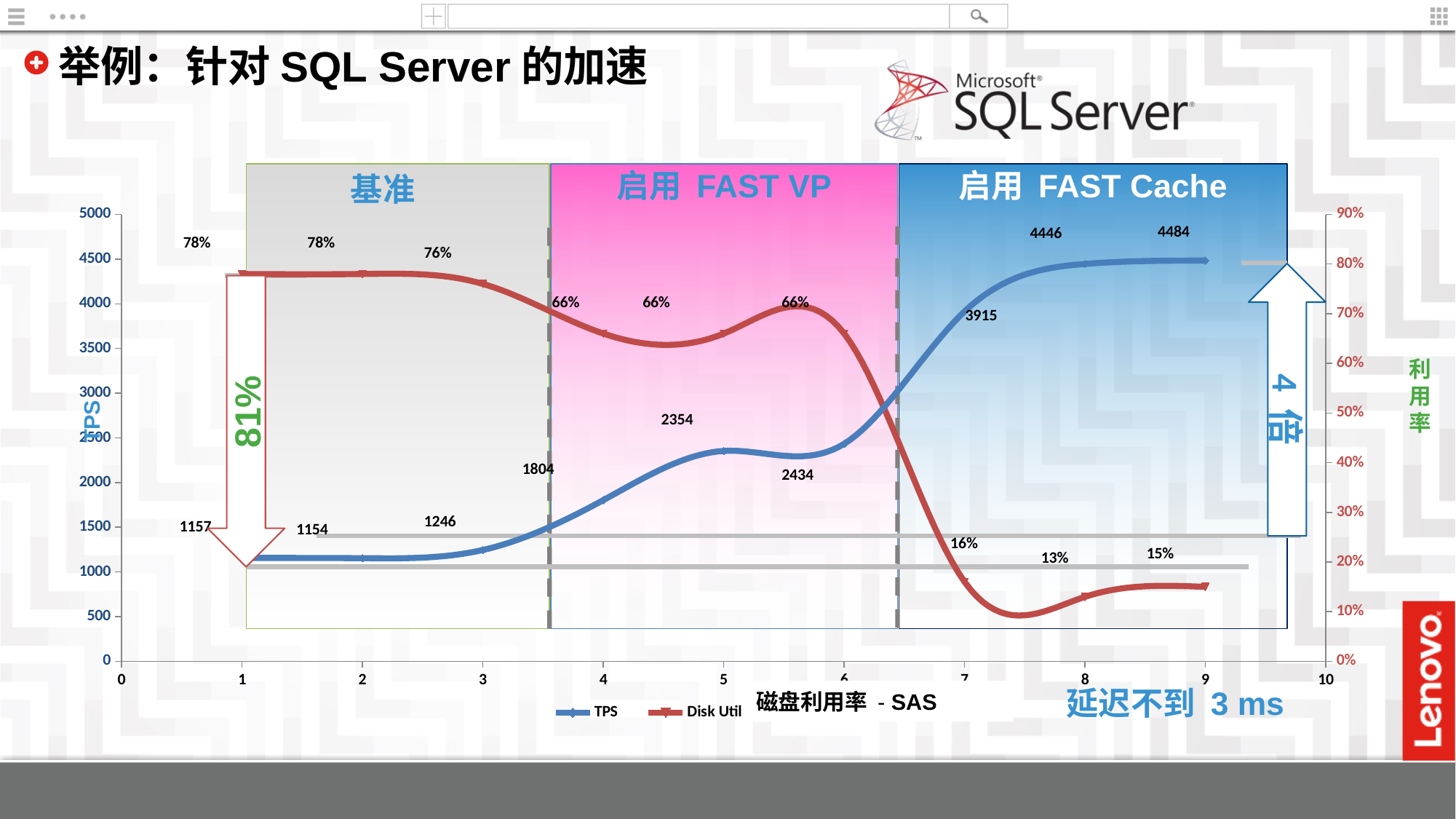
At which x value is Disk Util lowest? 8 What type of chart is shown on the slide? line chart What is the TPS value at x = 9? 4484 What are the two series named in the chart legend? TPS and Disk Util Which is larger, the TPS value at x = 5 or the TPS value at x = 6? x = 6 What is the difference between the TPS value at x = 9 and the TPS value at x = 1? 3327 What is the TPS value at x = 4? 1804 What is the Disk Util value at x = 1? 78% Does the TPS series rise or fall as x increases from 1 to 9? rise What is the Disk Util value at x = 8? 13% At which x value is TPS highest? 9 How many series does the chart legend list? 2